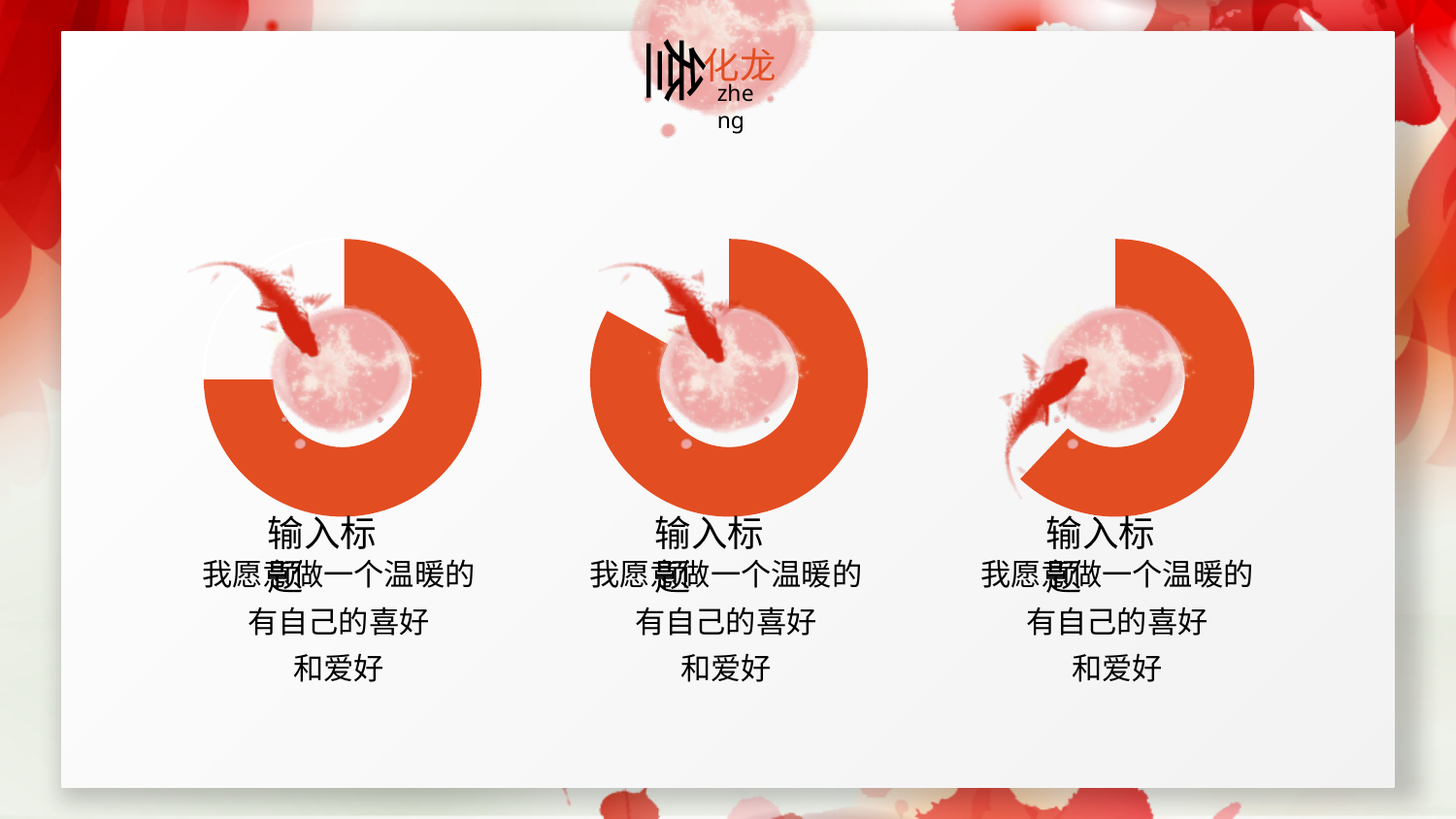
How many doughnut charts are shown on the slide? 3 What kind of chart is the left chart on the slide? doughnut chart How many segments does each doughnut chart show? 2 What colour is the filled portion of each doughnut chart? orange-red Which of the three doughnut charts has the largest filled (orange) portion? the middle chart Which of the three doughnut charts has the smallest filled (orange) portion? the right chart Is the filled portion of the middle doughnut chart larger or smaller than that of the left doughnut chart? larger Is the filled portion of the right doughnut chart larger or smaller than that of the left doughnut chart? smaller